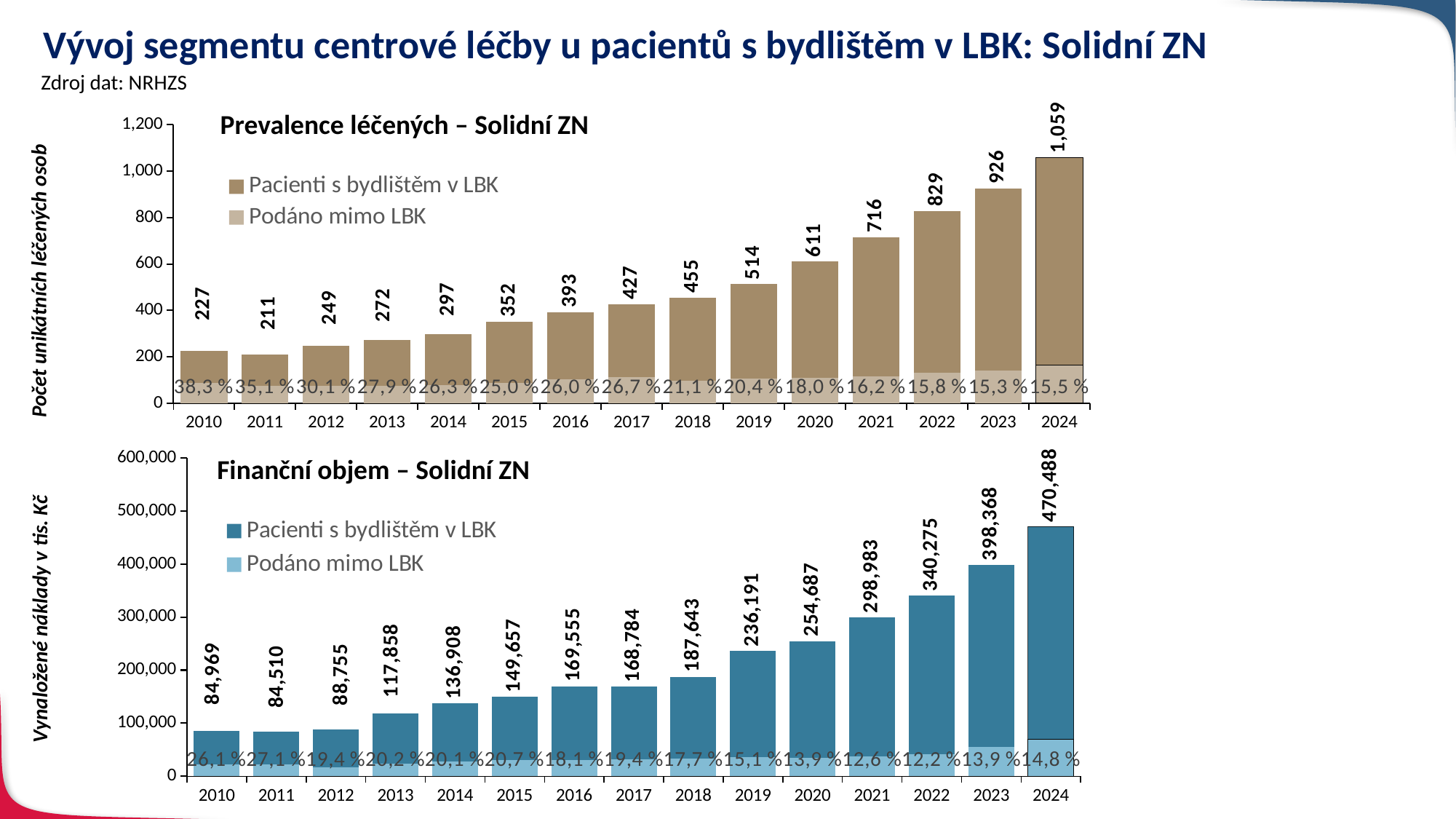
In the 'Prevalence léčených – Solidní ZN' chart, what is the value for 2024? 1,059 In the 'Prevalence léčených – Solidní ZN' chart, which year has the lowest value? 2011 In the 'Finanční objem – Solidní ZN' chart, which is larger, the value for 2016 or 2017? 2016 In the 'Finanční objem – Solidní ZN' chart, which year has the highest value? 2024 In the 'Finanční objem – Solidní ZN' chart, how many series does the legend list? 2 In the 'Finanční objem – Solidní ZN' chart, what is the difference between the values for 2024 and 2023? 72,120 In the 'Prevalence léčených – Solidní ZN' chart, what percentage label is shown for 2010? 38,3 % How many years are shown on the x axis of the 'Prevalence léčených – Solidní ZN' chart? 15 In the 'Prevalence léčených – Solidní ZN' chart, what is the difference between the values for 2023 and 2022? 97 What kind of chart is the 'Finanční objem – Solidní ZN' chart? Bar chart In the 'Finanční objem – Solidní ZN' chart, what is the value for 2019? 236,191 In the 'Prevalence léčených – Solidní ZN' chart, what is the value for 2015? 352